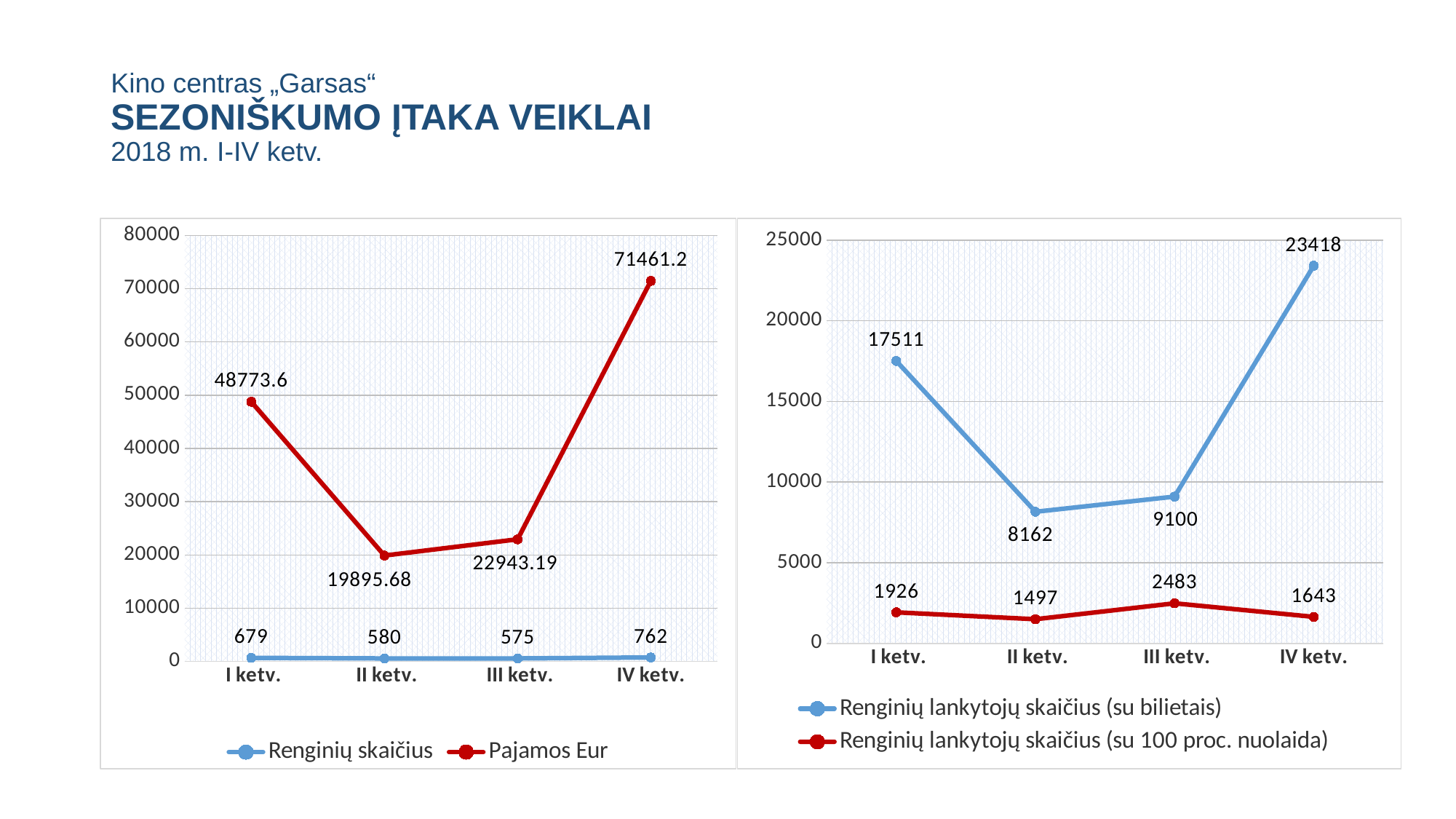
In the right chart, is the value of Renginių lankytojų skaičius (su 100 proc. nuolaida) for III ketv. greater or less than the value for II ketv.? greater What kind of chart is the right chart? line chart In the left chart, how many series does the legend list? 2 In the left chart, what is the value of Renginių skaičius for II ketv.? 580 In the left chart, which quarter has the highest Renginių skaičius? IV ketv. In the right chart, what is the value of Renginių lankytojų skaičius (su 100 proc. nuolaida) for I ketv.? 1926 In the left chart, what is the difference between Pajamos Eur for IV ketv. and I ketv.? 22687.6 In the right chart, which quarter has the highest Renginių lankytojų skaičius (su bilietais)? IV ketv. In the right chart, what is the value of Renginių lankytojų skaičius (su bilietais) for III ketv.? 9100 In the right chart, what is the difference between Renginių lankytojų skaičius (su bilietais) for IV ketv. and I ketv.? 5907 In the left chart, what is the value of Pajamos Eur for IV ketv.? 71461.2 In the left chart, which quarter has the lowest Pajamos Eur? II ketv.